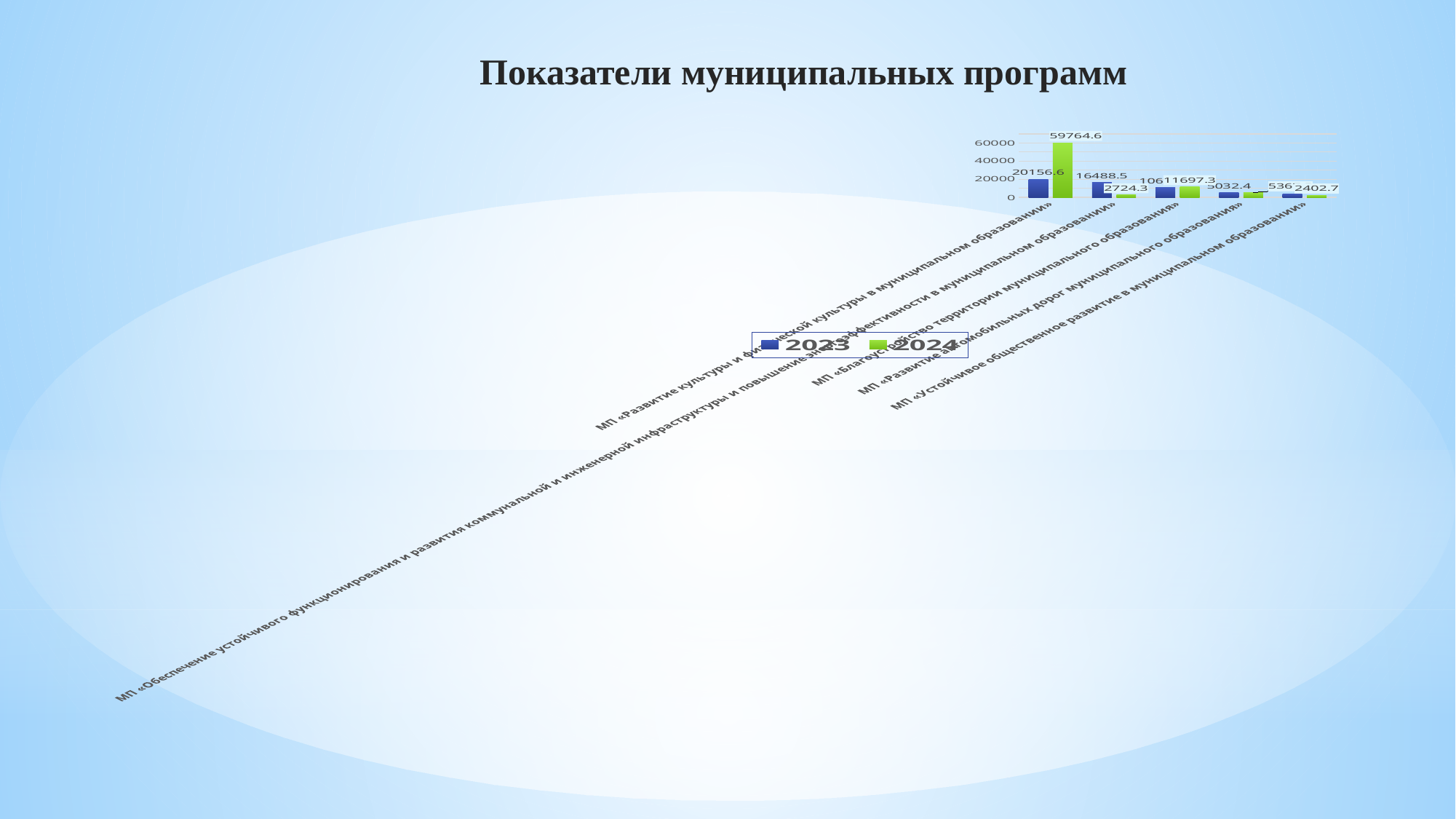
What kind of chart is shown on the slide? bar chart For МП «Благоустройство территории муниципального образования», which year has the larger value, 2023 or 2024? 2024 What is the 2023 value for МП «Развитие автомобильных дорог муниципального образования»? 5032.4 What is the title of the chart on the slide? Показатели муниципальных программ What is the 2024 value for МП «Развитие культуры и физической культуры в муниципальном образовании»? 59764.6 What is the 2023 value for МП «Развитие культуры и физической культуры в муниципальном образовании»? 20156.6 What is the 2024 value for МП «Благоустройство территории муниципального образования»? 11697.3 What is the 2023 value for МП «Обеспечение устойчивого функционирования и развития коммунальной и инженерной инфраструктуры...»? 16488.5 By how much does the 2024 value exceed the 2023 value for МП «Развитие культуры и физической культуры в муниципальном образовании»? 39608 How many municipal programmes (categories) are plotted on the chart? 5 Which programme has the highest 2024 value? МП «Развитие культуры и физической культуры в муниципальном образовании» How many series does the chart legend list? 2